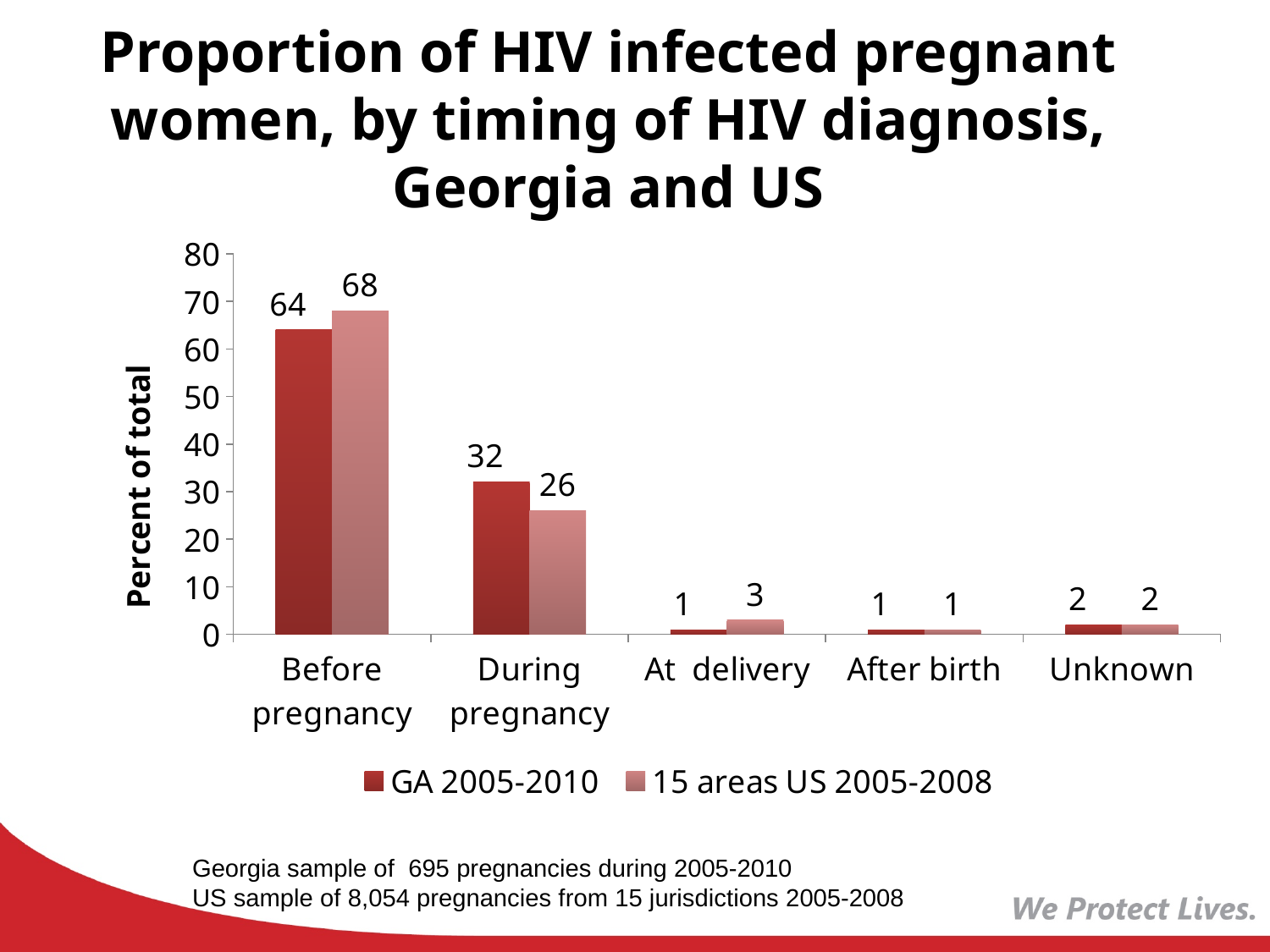
What is the value for 15 areas US 2005-2008 in the At delivery category? 3 What is the difference between the 15 areas US 2005-2008 and GA 2005-2010 values in the Before pregnancy category? 4 Which category has the highest value for GA 2005-2010? Before pregnancy What is the value for 15 areas US 2005-2008 in the During pregnancy category? 26 What is the value for GA 2005-2010 in the Before pregnancy category? 64 How many categories are shown on the x axis? 5 How many series does the legend list? 2 In the During pregnancy category, which series has the larger value, GA 2005-2010 or 15 areas US 2005-2008? GA 2005-2010 What kind of chart is shown on the slide? Bar chart What is the difference between the GA 2005-2010 and 15 areas US 2005-2008 values in the During pregnancy category? 6 Is the value for GA 2005-2010 in the Before pregnancy category greater or less than 60? greater What is the label of the y axis? Percent of total